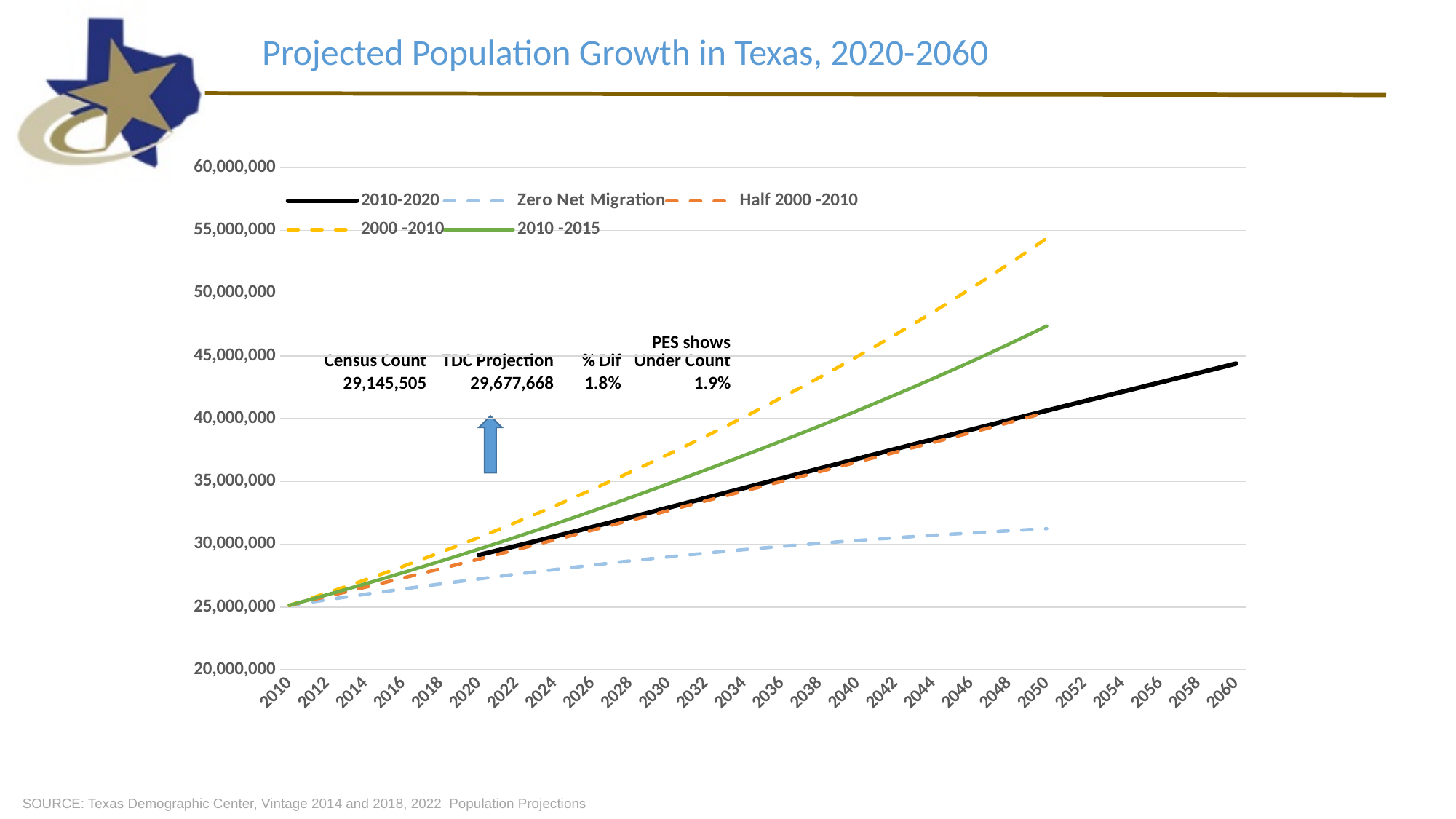
Is the value of the Zero Net Migration series in 2050 greater or less than 35,000,000? less Do the values of the 2010-2015 series rise or fall from 2010 to 2050? rise Is the value of the 2000 -2010 series in 2050 greater or less than 50,000,000? greater Is the value of the 2010 -2015 series in 2050 greater or less than 45,000,000? greater Which series has the lowest value in 2050? Zero Net Migration How many series does the legend list? 5 What kind of chart is shown on the slide? line chart Which series reaches the highest value by 2050? 2000 -2010 What is the title of the chart? Projected Population Growth in Texas, 2020-2060 Which series is the only one plotted out to 2060? 2010-2020 In 2050, which series is higher: 2010 -2015 or Zero Net Migration? 2010 -2015